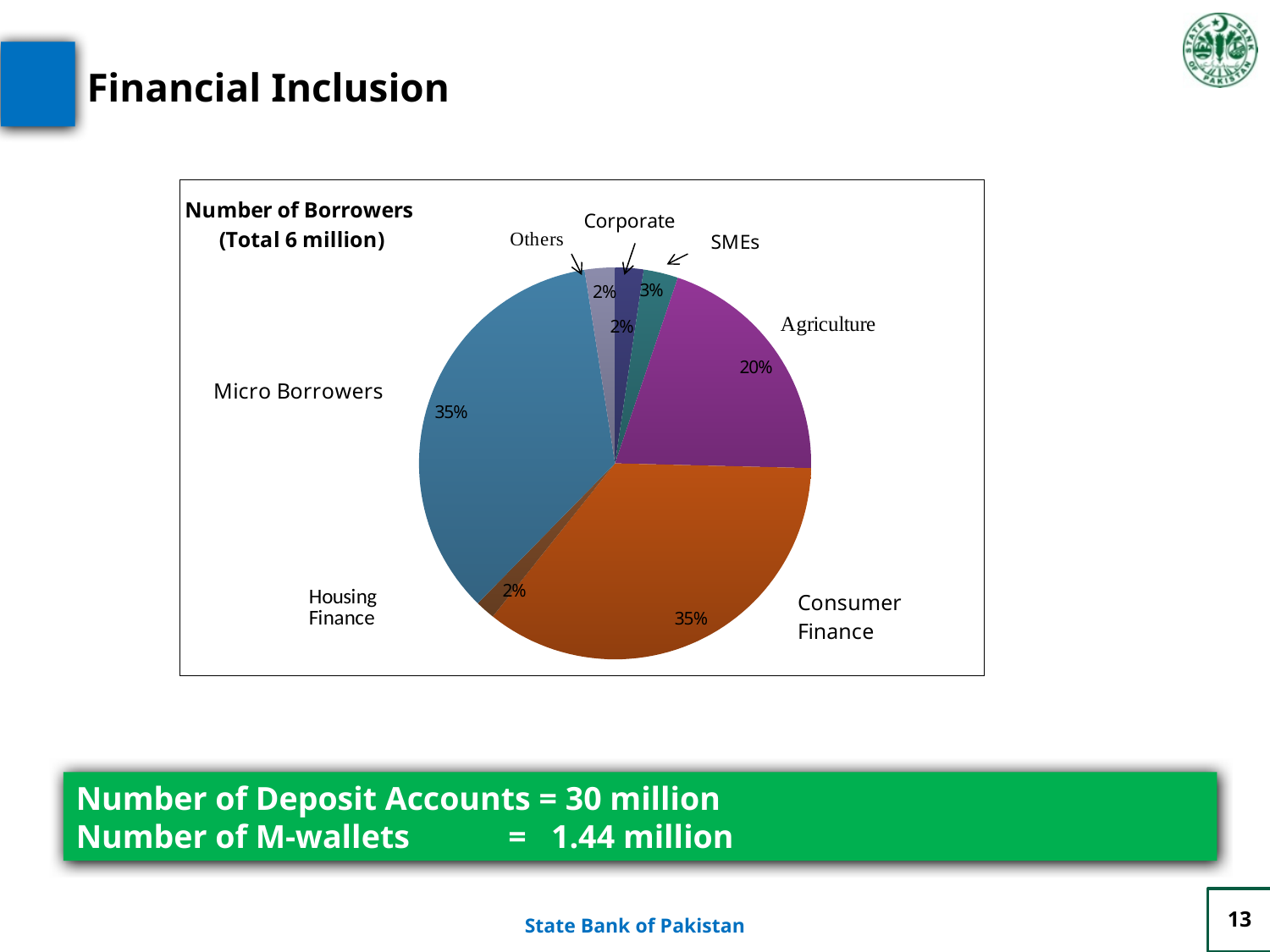
What share of borrowers is Corporate? 2% What share of borrowers is Agriculture? 20% What share of borrowers is Consumer Finance? 35% What total number of borrowers does the chart title state? 6 million What kind of chart is shown on the slide? pie chart What is the difference between the Micro Borrowers share and the Agriculture share? 15% Which is larger, the Agriculture share or the SMEs share? Agriculture How many categories does the pie chart show? 7 What is the difference between the Agriculture share and the SMEs share? 17%